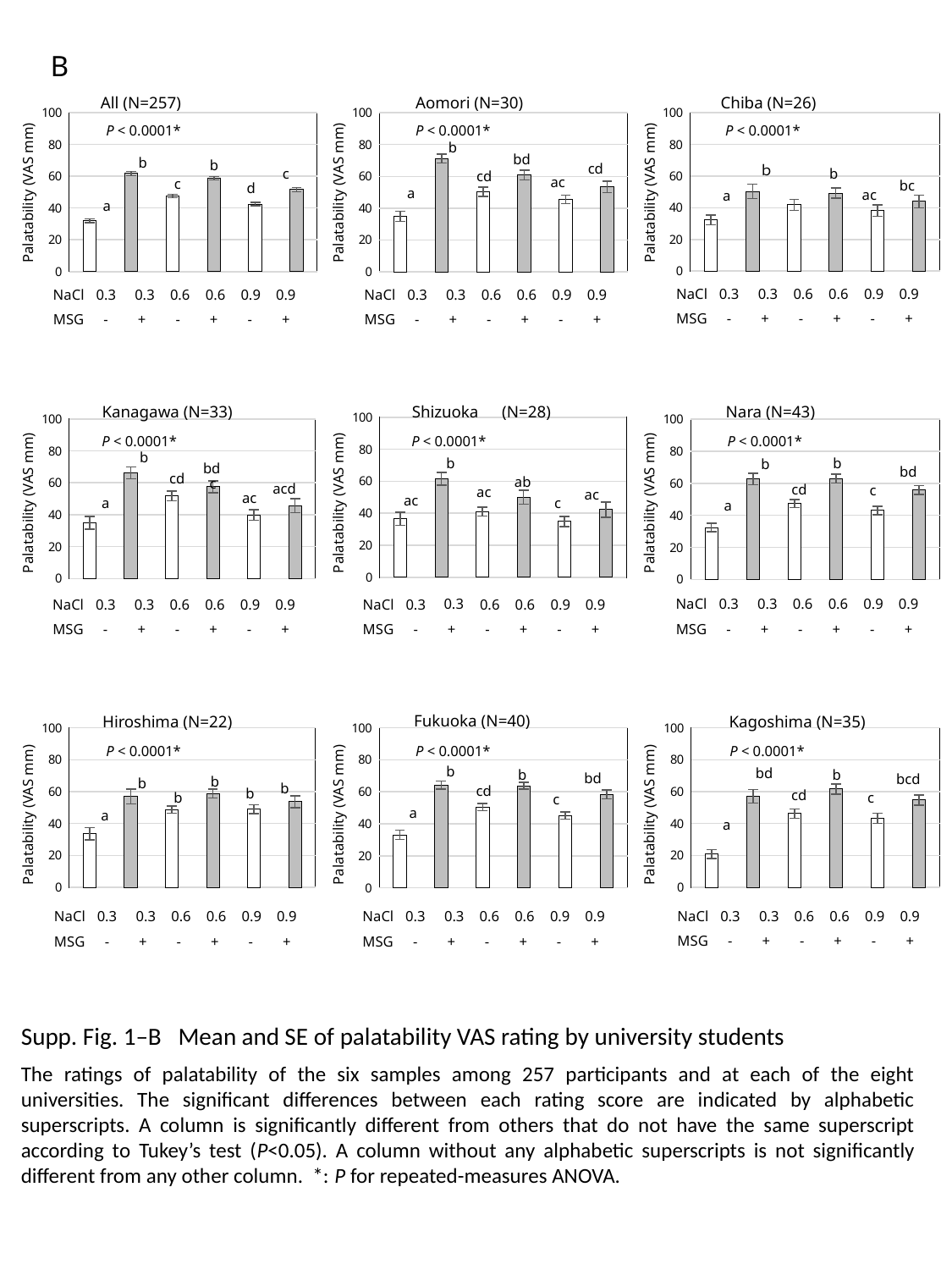
How many bar charts are shown on the slide? 9 In the Shizuoka (N=28) chart, which is larger: the value for NaCl 0.3 with MSG or NaCl 0.6 with MSG? NaCl 0.3 with MSG In the Kanagawa (N=33) chart, which bar is the highest? NaCl 0.3 with MSG In the Aomori (N=30) chart, which bar is the highest? NaCl 0.3 with MSG In the All (N=257) chart, how many bars are plotted? 6 In the All (N=257) chart, which bar is the lowest? NaCl 0.3 without MSG In the Aomori (N=30) chart, is the value for NaCl 0.3 with MSG greater or less than 60? greater What kind of chart is used in each of the nine panels on the slide? bar chart In the Chiba (N=26) chart, is the value for NaCl 0.3 without MSG greater or less than 40? less In the Fukuoka (N=40) chart, is the value for NaCl 0.3 without MSG greater or less than 40? less What is the y-axis label on the charts? Palatability (VAS mm) In the Kagoshima (N=35) chart, which bar is the lowest? NaCl 0.3 without MSG